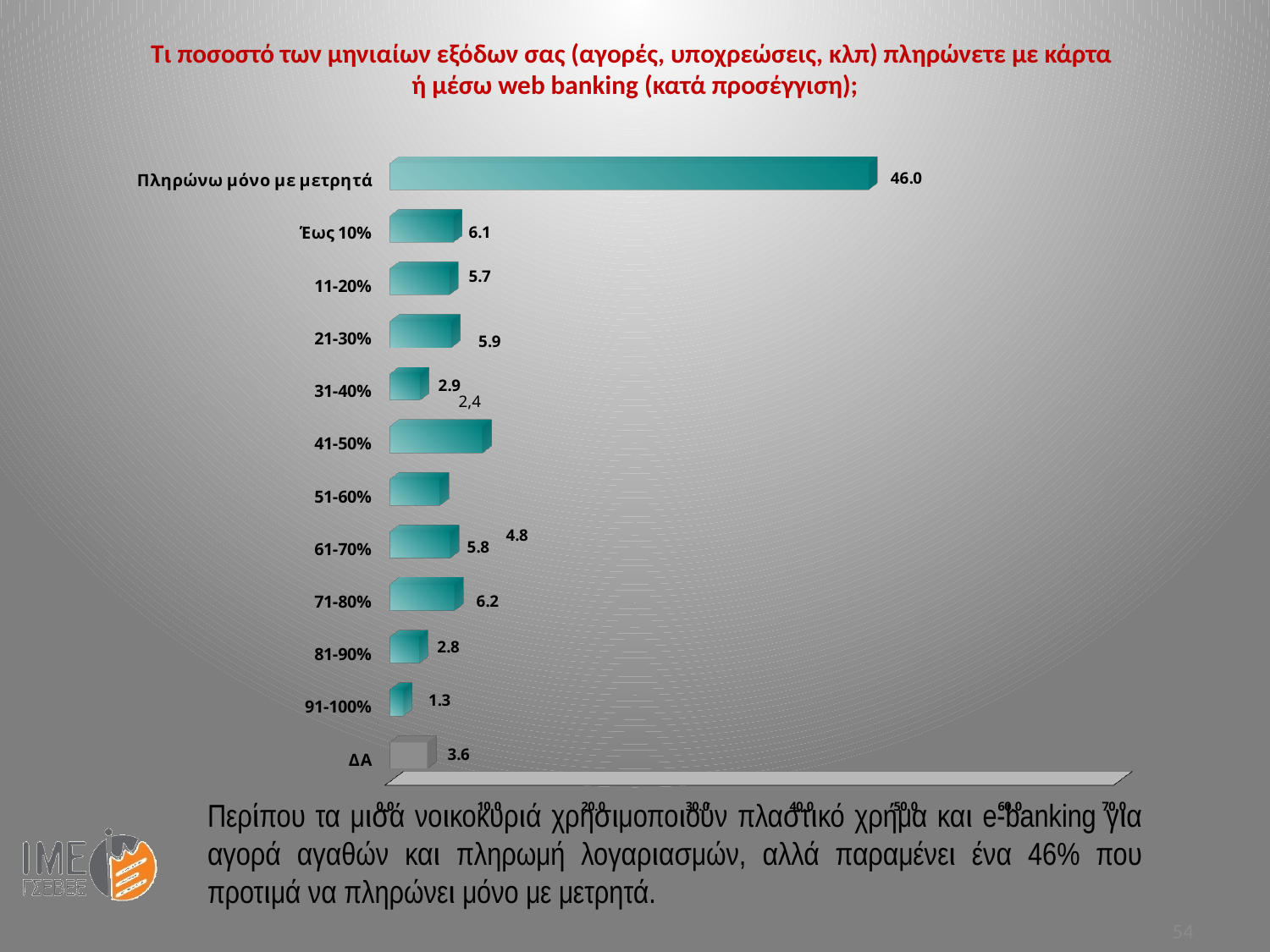
Which category has the lowest value? 91-100% Which is larger, the value for '71-80%' or the value for '81-90%'? 71-80% What is the difference between the values for 'Πληρώνω μόνο με μετρητά' and 'Έως 10%'? 39.9 What is the value for the '71-80%' category? 6.2 Which category has the highest value? Πληρώνω μόνο με μετρητά What kind of chart is shown on the slide? bar chart What is the difference between the values for '71-80%' and '81-90%'? 3.4 What is the value for 'ΔΑ'? 3.6 How many categories are shown in the chart? 12 What is the value for 'Πληρώνω μόνο με μετρητά'? 46.0 What is the value for the '91-100%' category? 1.3 Is the value for 'Πληρώνω μόνο με μετρητά' greater or less than 40.0? greater